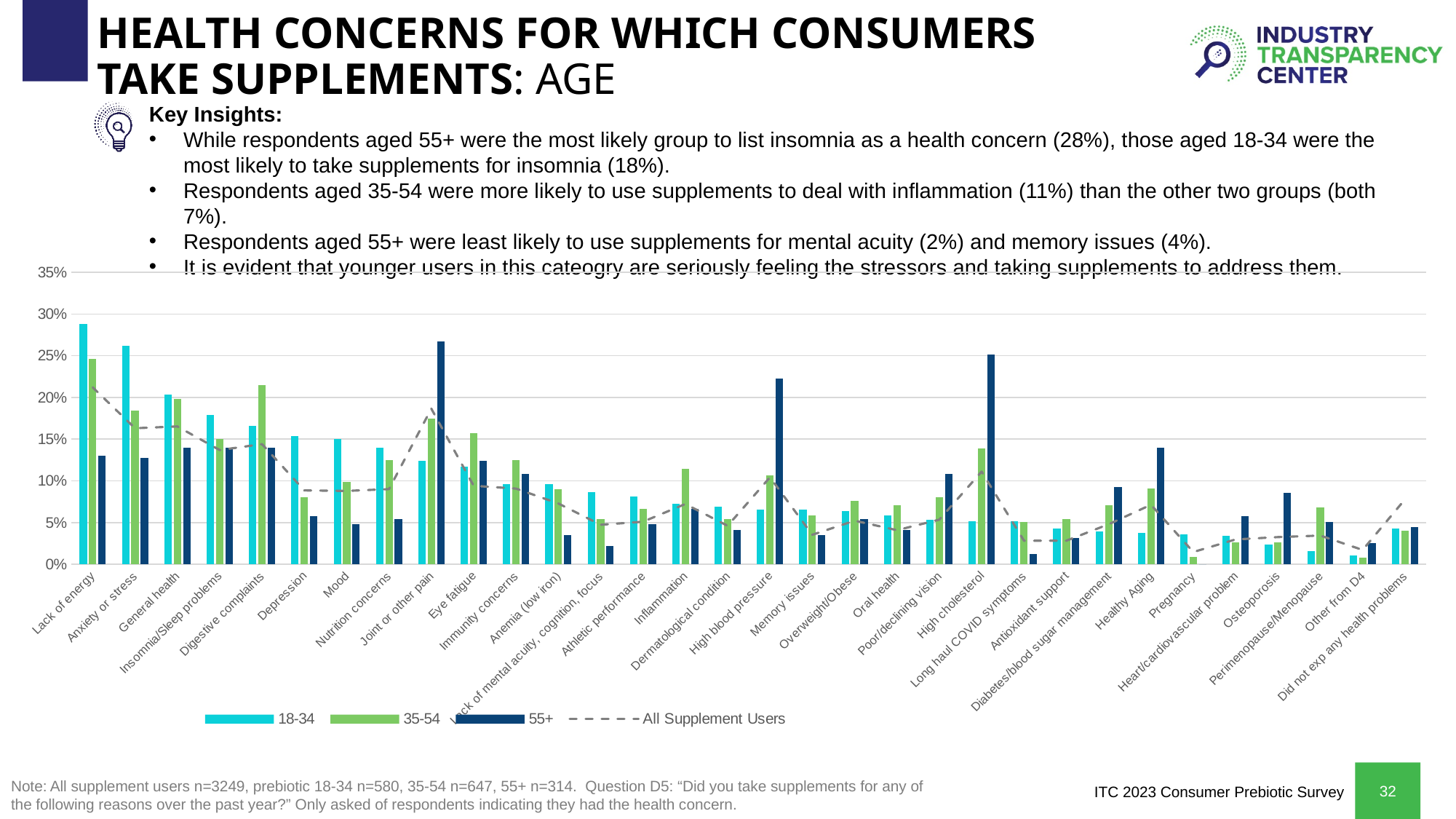
Is the 18-34 value for Lack of energy greater or less than 25%? greater What kind of chart is shown on the slide? combination bar and line chart For Joint or other pain, which is larger: the 55+ value or the 18-34 value? 55+ Is the 55+ value for High blood pressure greater or less than 20%? greater How many series does the chart legend list? 4 Which category has the highest value for the 55+ series? Joint or other pain How many health concern categories are shown along the x axis? 32 Is the 55+ value for Long haul COVID symptoms greater or less than 5%? less Which category has the highest value for the 18-34 series? Lack of energy Which series is drawn as a dashed line rather than bars? All Supplement Users For Inflammation, which is larger: the 35-54 value or the 18-34 value? 35-54